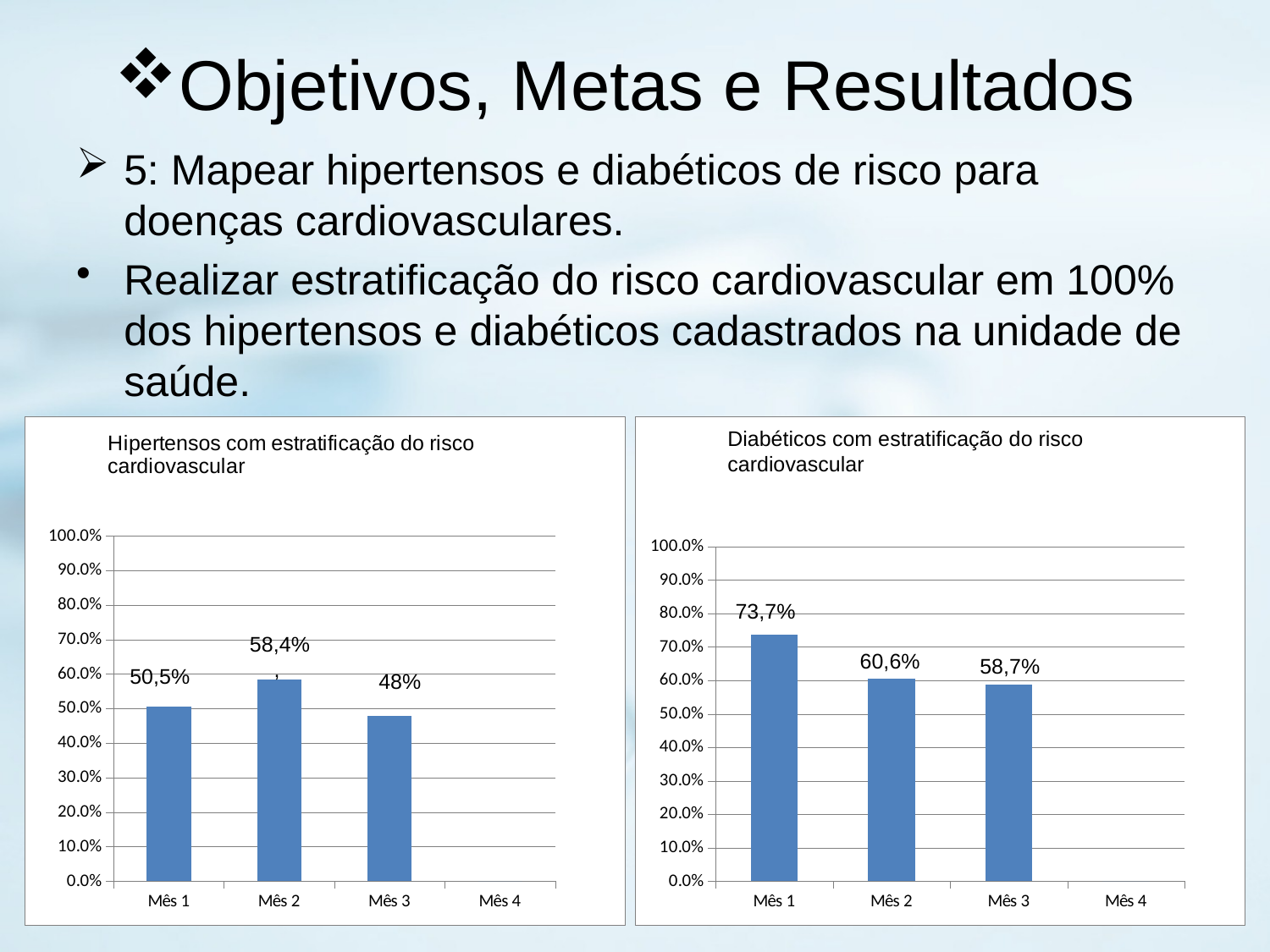
In the chart titled 'Diabéticos com estratificação do risco cardiovascular', which month has the highest value? Mês 1 In the chart titled 'Hipertensos com estratificação do risco cardiovascular', what is the difference between the values for Mês 2 and Mês 1? 7,9 percentage points In the chart titled 'Hipertensos com estratificação do risco cardiovascular', what is the value for Mês 2? 58,4% In the chart titled 'Diabéticos com estratificação do risco cardiovascular', do the values rise or fall from Mês 1 to Mês 3? Fall What kind of chart is the chart on the right of the slide? Bar chart In the chart titled 'Hipertensos com estratificação do risco cardiovascular', what is the value for Mês 3? 48% In the chart titled 'Diabéticos com estratificação do risco cardiovascular', what is the value for Mês 1? 73,7% In the chart titled 'Hipertensos com estratificação do risco cardiovascular', how many months have a bar plotted? 3 Comparing the two charts, which is larger: the Mês 2 value for Hipertensos or the Mês 2 value for Diabéticos? Diabéticos (60,6%) In the chart titled 'Diabéticos com estratificação do risco cardiovascular', what is the difference between the values for Mês 1 and Mês 3? 15 percentage points In the chart titled 'Diabéticos com estratificação do risco cardiovascular', is the value for Mês 1 greater or less than 70.0%? greater